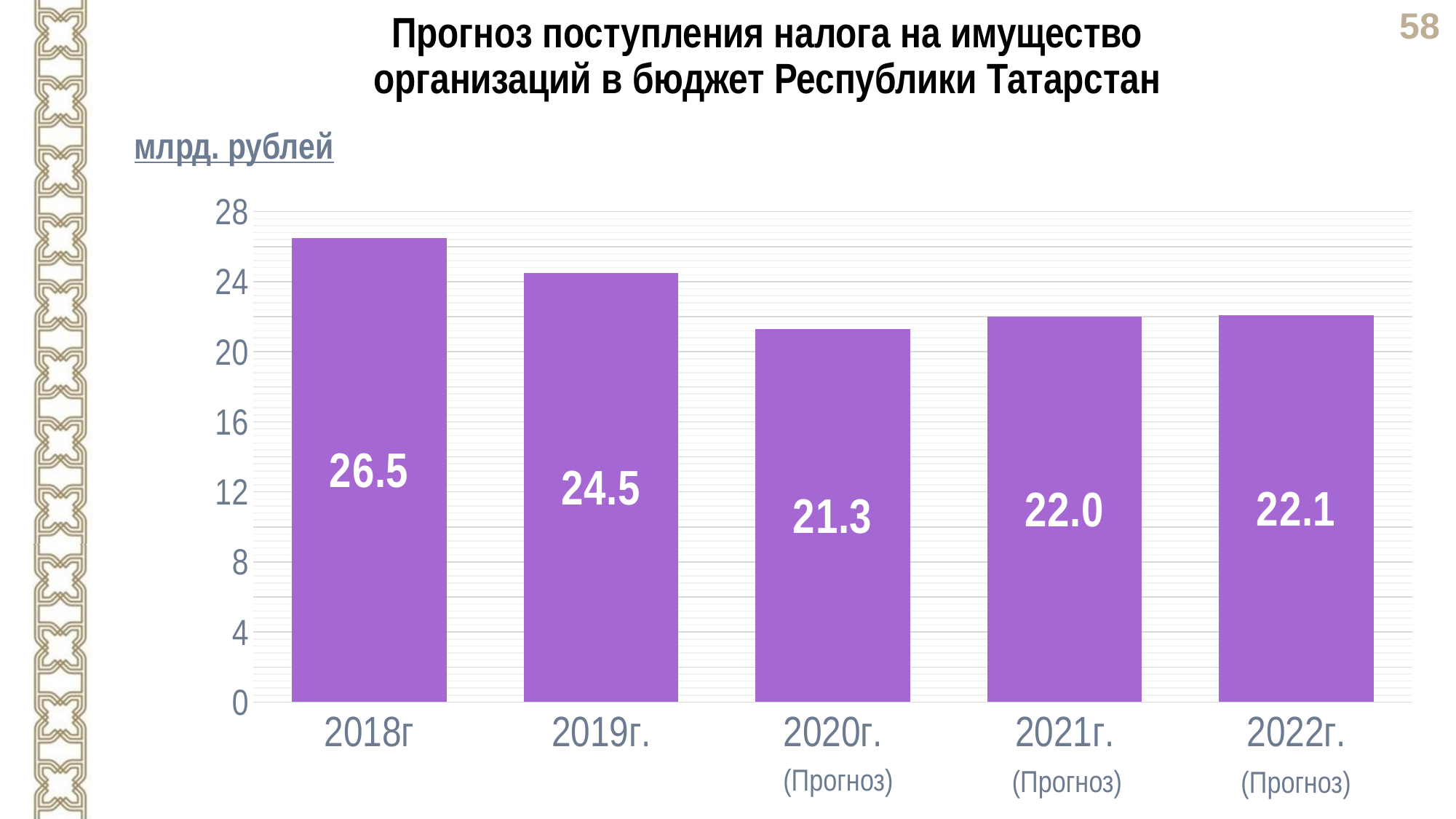
Which year has the lowest value? 2020г. (Прогноз) What is the difference between the values for 2019г. and 2020г. (Прогноз)? 3.2 What is the value for 2020г. (Прогноз)? 21.3 How many years are shown on the chart? 5 What is the difference between the values for 2018г and 2019г.? 2.0 What is the value for 2018г? 26.5 Which is larger, the value for 2019г. or the value for 2021г. (Прогноз)? 2019г. Is the value for 2021г. (Прогноз) greater or less than 24? less Which year has the highest value? 2018г What kind of chart is this? bar chart What unit is stated above the chart? млрд. рублей What is the value for 2022г. (Прогноз)? 22.1